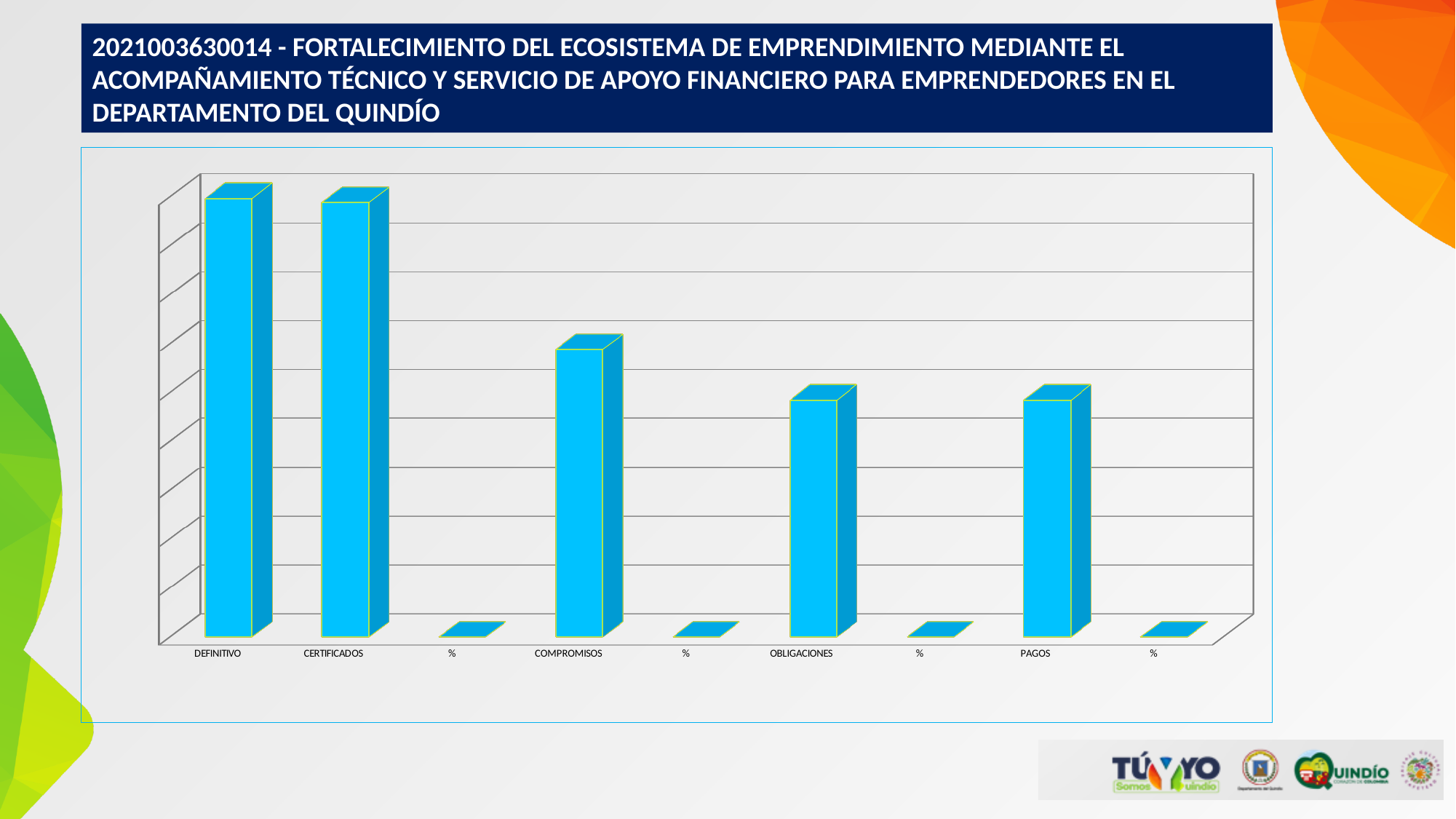
What kind of chart is shown on the slide? bar chart Which is larger in the chart, the value for CERTIFICADOS or the value for PAGOS? CERTIFICADOS What is the label of the first category on the x axis of the chart? DEFINITIVO Which is larger in the chart, the value for COMPROMISOS or the value for PAGOS? COMPROMISOS Which is larger in the chart, the value for COMPROMISOS or the value for OBLIGACIONES? COMPROMISOS How many categories are shown along the x axis of the chart? 9 What colour are the bars in the chart? blue